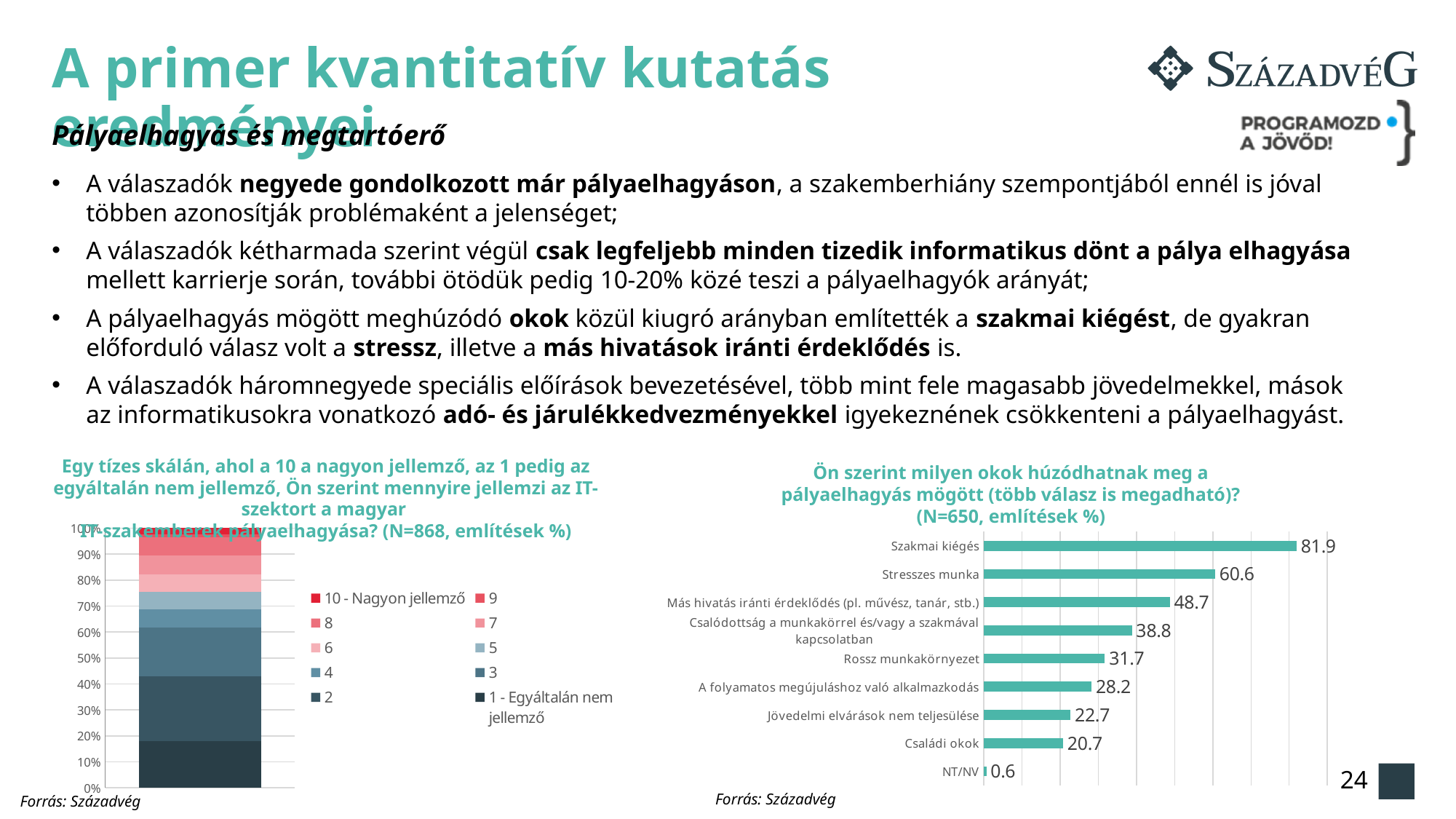
On the right chart, which category has the highest value? Szakmai kiégés On the right chart, how many categories are plotted? 9 What kind of chart is the left chart? Stacked bar chart On the right chart, which category has the lowest value? NT/NV On the right chart, what is the value for Stresszes munka? 60.6 On the right chart (Ön szerint milyen okok húzódhatnak meg a pályaelhagyás mögött), what is the value for Szakmai kiégés? 81.9 On the left chart (Egy tízes skálán...), how many series does the legend list? 10 On the right chart, what is the value for Családi okok? 20.7 What kind of chart is the right chart? Bar chart On the right chart, which is larger: Rossz munkakörnyezet or Jövedelmi elvárások nem teljesülése? Rossz munkakörnyezet On the right chart, what is the value for A folyamatos megújuláshoz való alkalmazkodás? 28.2 On the right chart, what is the difference between Szakmai kiégés and Stresszes munka? 21.3